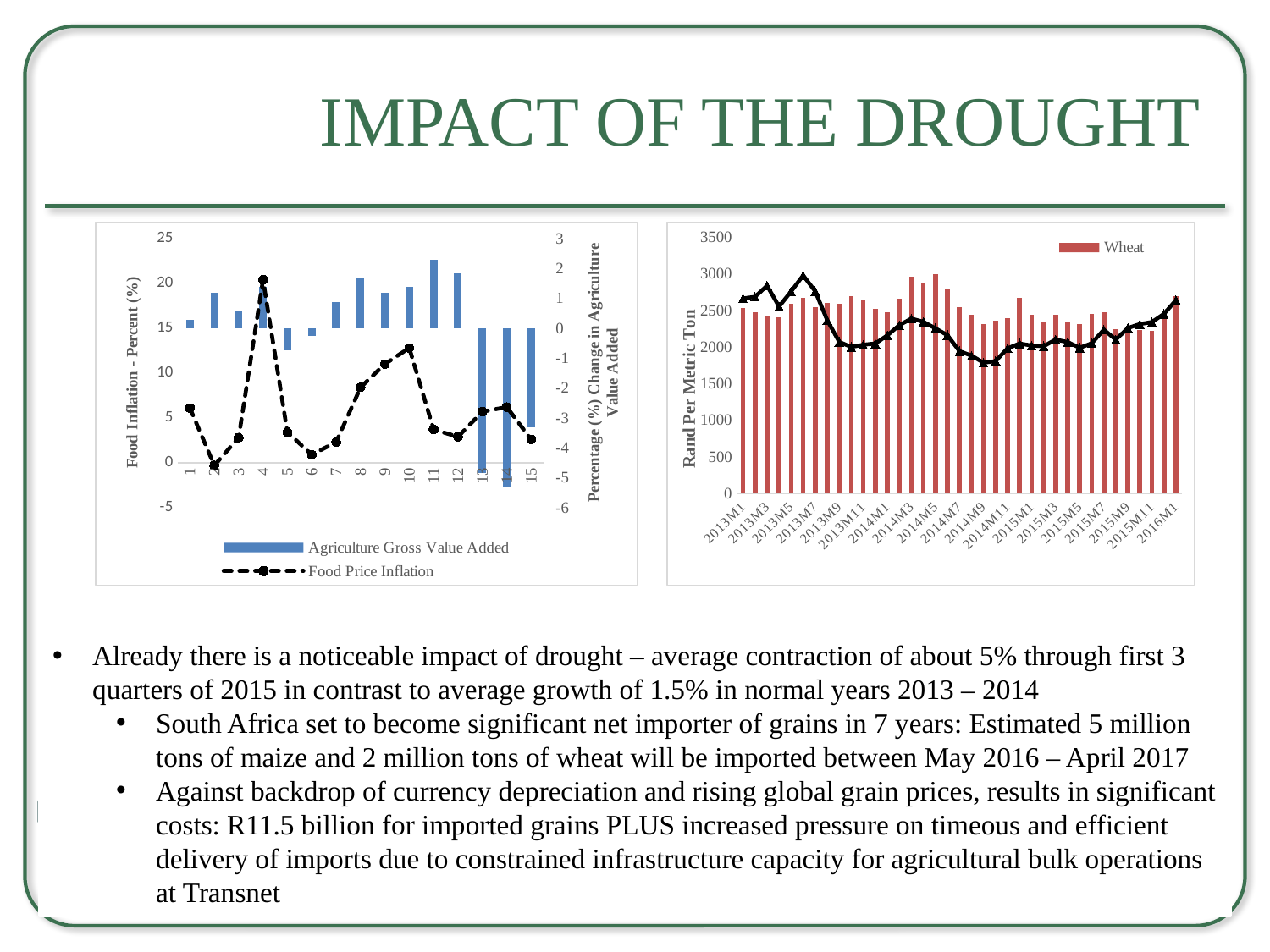
On the left chart, which is larger: Food Price Inflation at category 10 or at category 12? category 10 On the left chart, is the Food Price Inflation value at category 4 greater or less than 15? greater On the left chart, at which category is the Agriculture Gross Value Added bar the highest? 11 On the left chart, how many categories are shown on the x axis? 15 On the right chart, how many series does the legend list? 1 On the left chart, is the Agriculture Gross Value Added value at category 14 greater or less than -4? less On the left chart, at which category does Food Price Inflation reach its highest value? 4 On the left chart, at which category is the Agriculture Gross Value Added bar the lowest? 14 On the right chart, is the Wheat value for 2014M5 greater or less than 2500? greater What is the y-axis title of the right chart? Rand Per Metric Ton On the left chart, how many series does the legend list? 2